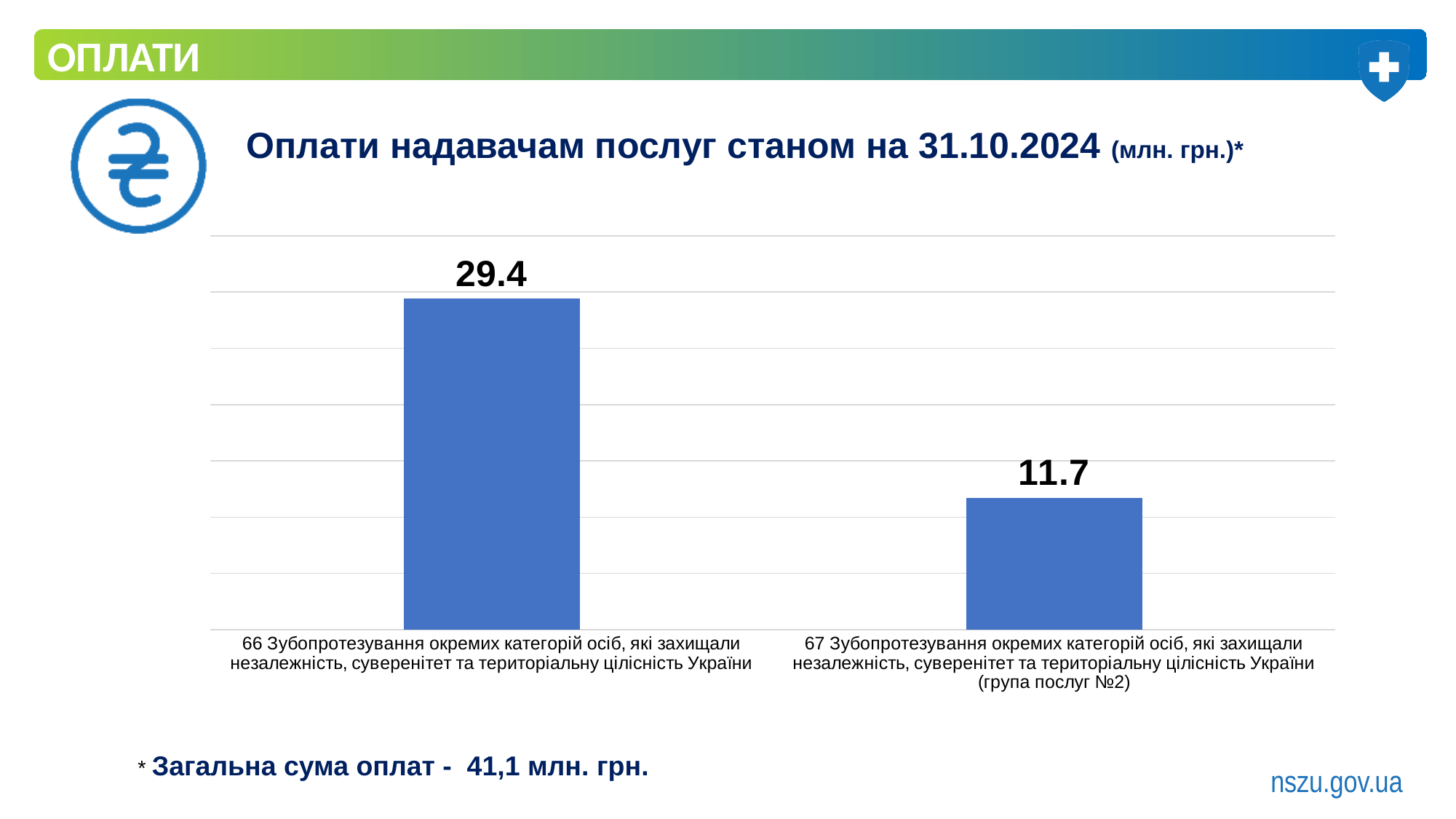
Which is larger: the value for category 66 or the value for category 67? Category 66 How many categories are shown in the chart? 2 What is the value for category 66 (Зубопротезування окремих категорій осіб, які захищали незалежність, суверенітет та територіальну цілісність України)? 29.4 Do the values rise or fall from the left bar to the right bar? Fall What is the difference between the values for category 66 and category 67? 17.7 What is the title of the chart? Оплати надавачам послуг станом на 31.10.2024 (млн. грн.)* What kind of chart is shown on the slide? Bar chart Which category has the highest value? 66 Зубопротезування окремих категорій осіб, які захищали незалежність, суверенітет та територіальну цілісність України What total sum of payments is stated in the footnote below the chart? 41,1 млн. грн. Which category has the lowest value? 67 Зубопротезування окремих категорій осіб, які захищали незалежність, суверенітет та територіальну цілісність України (група послуг №2) What is the value for category 67 (Зубопротезування окремих категорій осіб ... (група послуг №2))? 11.7